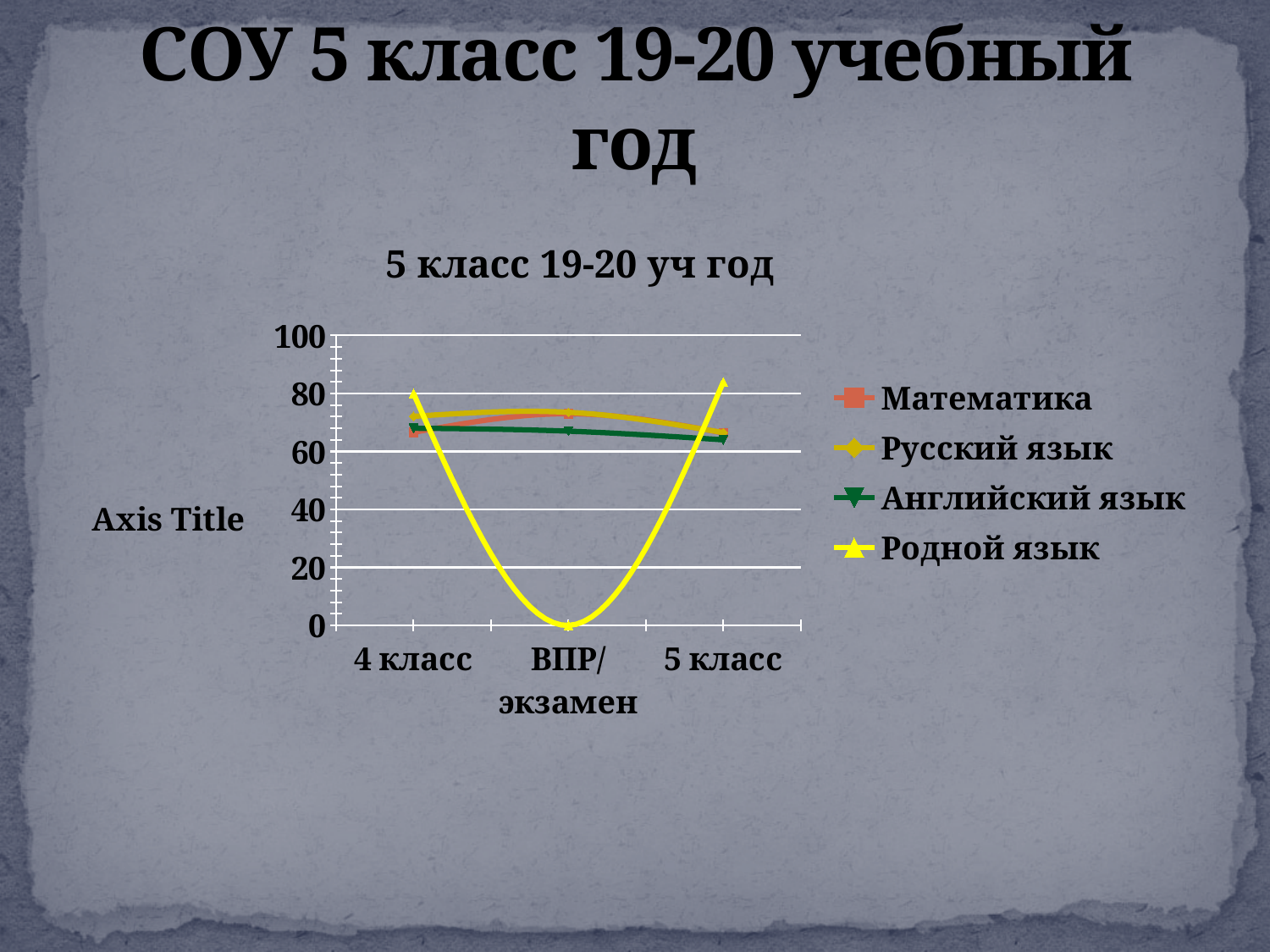
Which is larger at ВПР/экзамен, Математика or Родной язык? Математика What is the title of the chart? 5 класс 19-20 уч год How many series does the legend list? 4 Is the value for Математика at 4 класс greater or less than 60? greater Does the value for Родной язык rise or fall from 4 класс to ВПР/экзамен? fall What kind of chart is shown on the slide? line chart Is the value for Английский язык at 5 класс greater or less than 80? less Which series has the lowest value at ВПР/экзамен? Родной язык How many categories are on the x axis? 3 Which series has the highest value at 5 класс? Родной язык What is the value for Родной язык at ВПР/экзамен? 0 Is the value for Родной язык at 5 класс greater or less than 80? greater